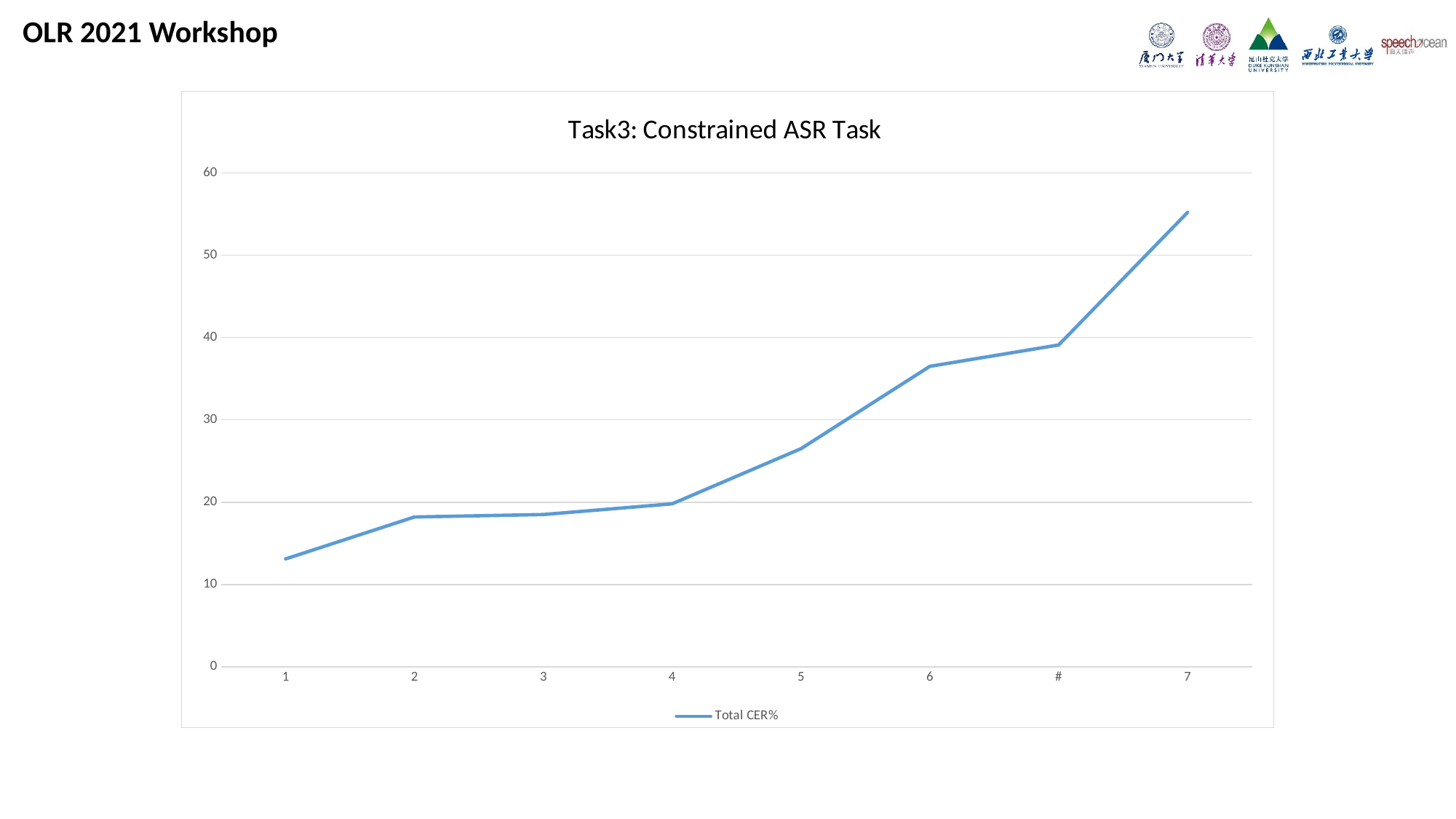
Which x-axis category has the lowest Total CER% value? 1 Is the Total CER% value for category 1 greater or less than 20? less What is the title of the chart? Task3: Constrained ASR Task What is the name of the series shown in the legend? Total CER% Which has the larger Total CER% value, category 4 or category 6? 6 Is the Total CER% value for category 7 greater or less than 50? greater What kind of chart is shown on the slide? line chart How many points are plotted along the x axis? 8 Which x-axis category has the highest Total CER% value? 7 How many series does the legend list? 1 Is the Total CER% value for category 6 greater or less than 30? greater Do the Total CER% values rise or fall from left to right along the x axis? rise